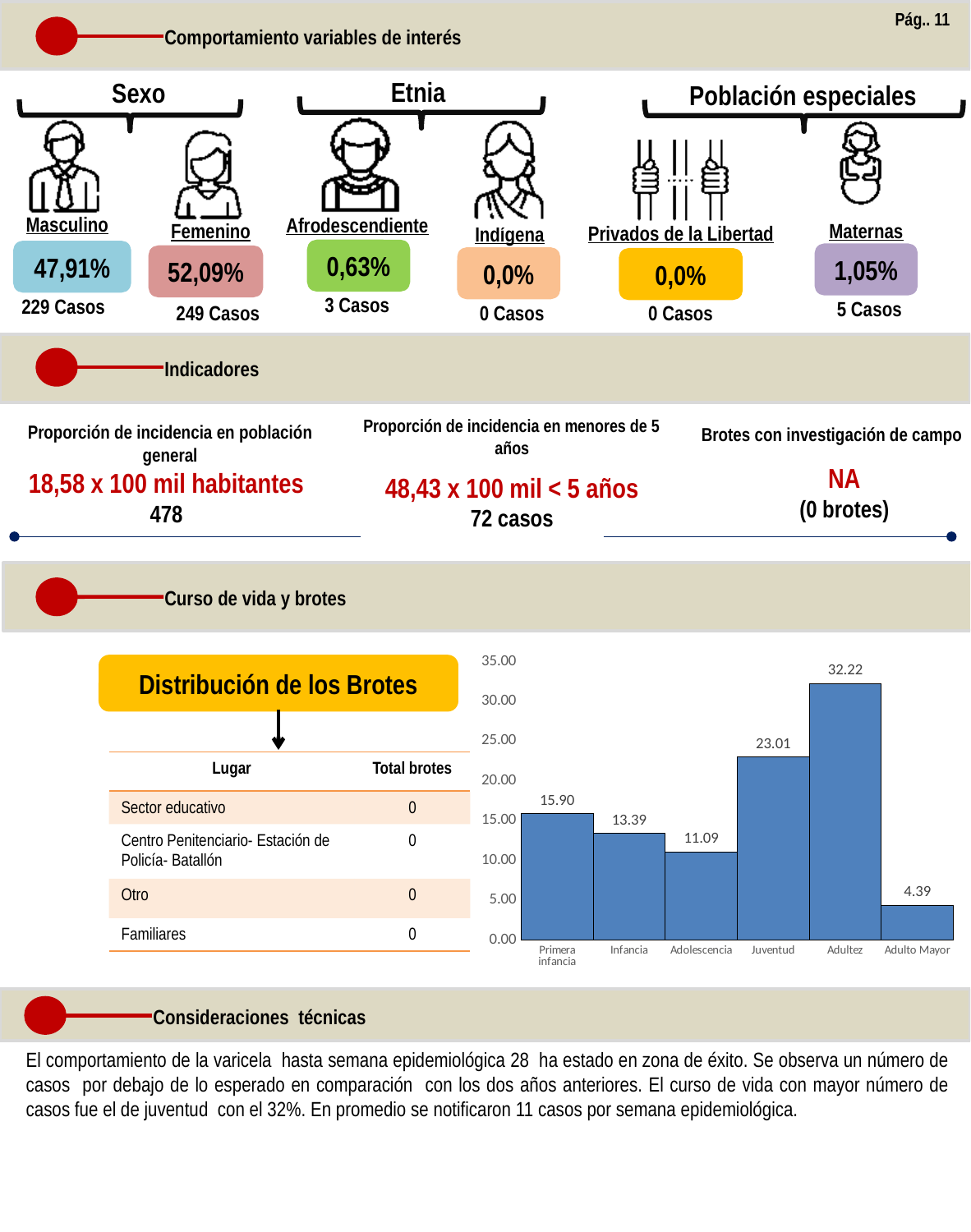
In the bar chart under 'Curso de vida y brotes', what is the value for Juventud? 23.01 In the bar chart under 'Curso de vida y brotes', how many categories are shown on the x axis? 6 In the bar chart under 'Curso de vida y brotes', is the value for Adolescencia greater or less than 15.00? less In the bar chart under 'Curso de vida y brotes', what is the difference between the values for Primera infancia and Adulto Mayor? 11.51 In the bar chart under 'Curso de vida y brotes', what is the highest value shown on the y axis? 35.00 What kind of chart is shown under 'Curso de vida y brotes'? bar chart In the bar chart under 'Curso de vida y brotes', what is the value for Primera infancia? 15.90 In the bar chart under 'Curso de vida y brotes', what is the difference between the values for Adultez and Juventud? 9.21 In the bar chart under 'Curso de vida y brotes', what is the value for Adultez? 32.22 In the bar chart under 'Curso de vida y brotes', which is larger, the value for Infancia or the value for Adolescencia? Infancia In the bar chart under 'Curso de vida y brotes', which category has the highest value? Adultez In the bar chart under 'Curso de vida y brotes', which category has the lowest value? Adulto Mayor